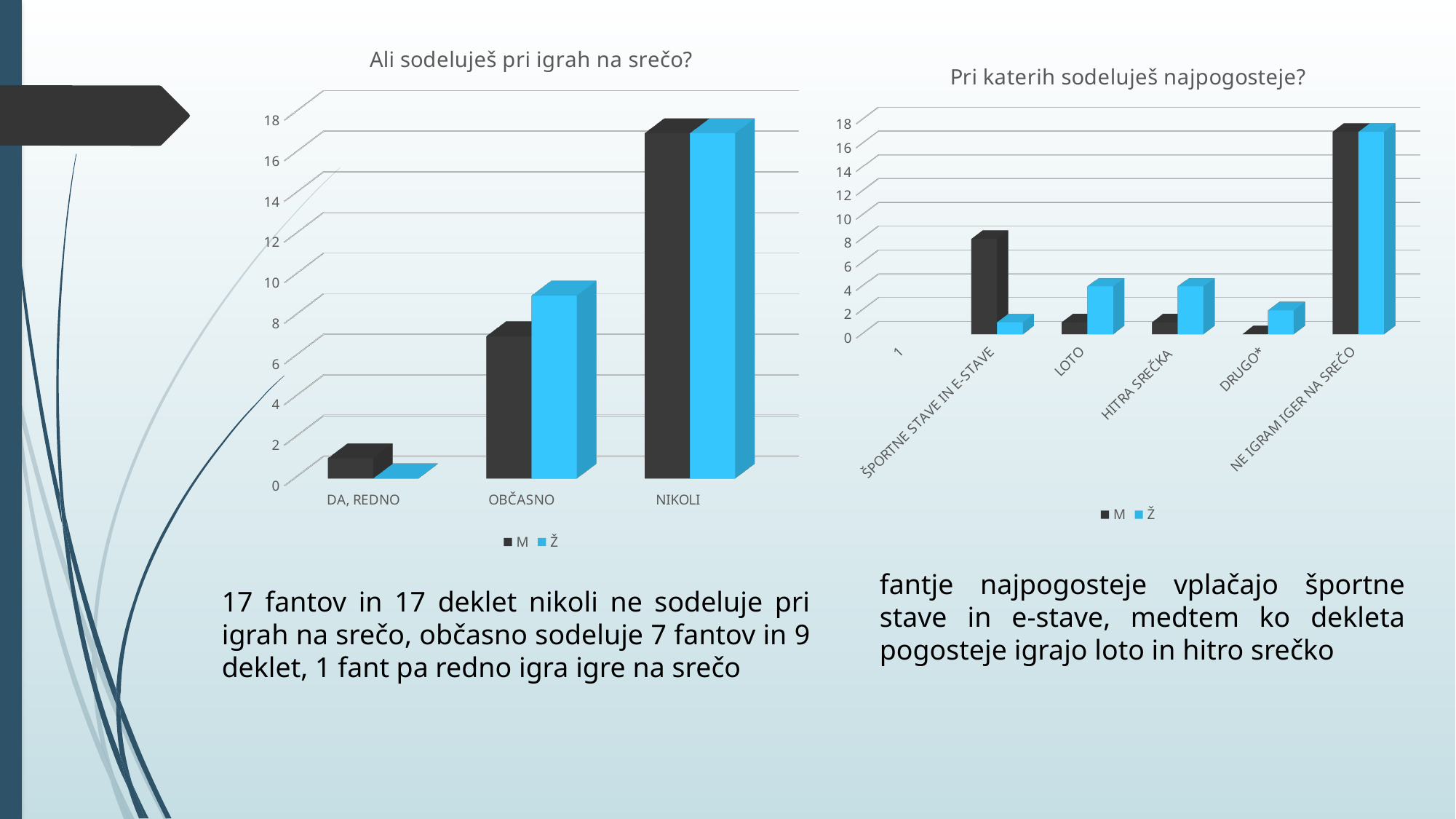
On the chart titled 'Ali sodeluješ pri igrah na srečo?', how many categories are shown on the x axis? 3 On the chart titled 'Pri katerih sodeluješ najpogosteje?', is the value for Ž in NE IGRAM IGER NA SREČO greater or less than 14? greater On the chart titled 'Ali sodeluješ pri igrah na srečo?', what is the value for M in the NIKOLI category? 17 On the chart titled 'Ali sodeluješ pri igrah na srečo?', do the M values rise or fall from DA, REDNO to NIKOLI? rise On the chart titled 'Ali sodeluješ pri igrah na srečo?', what is the value for Ž in the OBČASNO category? 9 On the chart titled 'Pri katerih sodeluješ najpogosteje?', which is larger in the LOTO category, M or Ž? Ž On the chart titled 'Pri katerih sodeluješ najpogosteje?', how many series does the legend list? 2 What type of chart is the chart titled 'Pri katerih sodeluješ najpogosteje?'? bar chart On the chart titled 'Pri katerih sodeluješ najpogosteje?', is the value for M in ŠPORTNE STAVE IN E-STAVE greater or less than 6? greater On the chart titled 'Ali sodeluješ pri igrah na srečo?', what is the difference between the Ž and M values in the OBČASNO category? 2 On the chart titled 'Ali sodeluješ pri igrah na srečo?', which category has the highest value for M? NIKOLI On the chart titled 'Ali sodeluješ pri igrah na srečo?', what is the value for M in the DA, REDNO category? 1